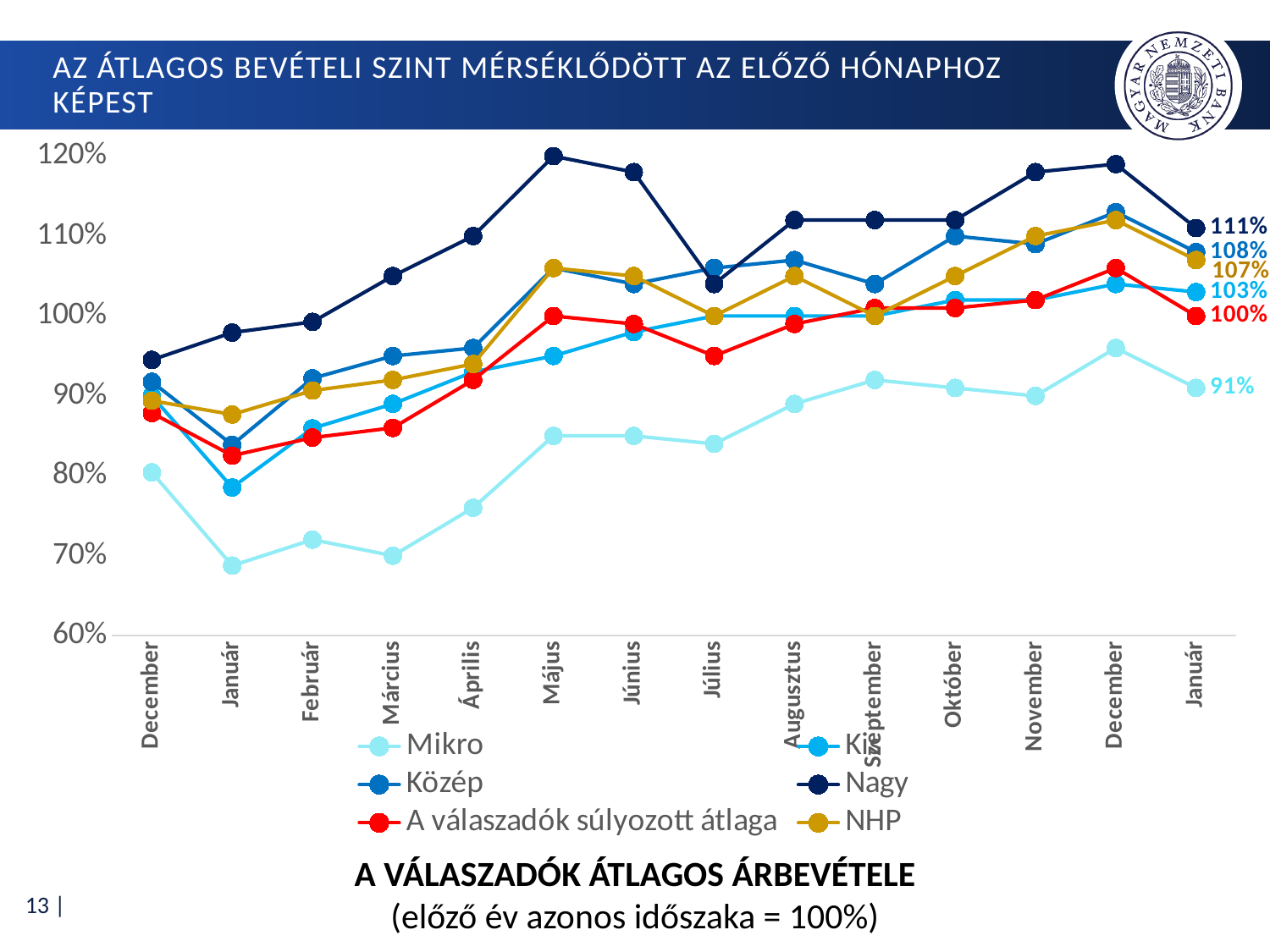
Which series has the lowest value at the final Január point? Mikro Is the value for Nagy in Május greater or less than 110%? greater What is the value for the Nagy series at the final Január point? 111% What is the difference between the Nagy and Mikro values at the final Január point? 20 percentage points What is the value for the NHP series at the final Január point? 107% What is the value for the Mikro series at the final Január point? 91% What is the value for the Közép series at the final Január point? 108% What is the title printed below the chart? A VÁLASZADÓK ÁTLAGOS ÁRBEVÉTELE What kind of chart is shown on the slide? line chart Which series has the highest value at the final Január point? Nagy How many series does the legend list? 6 At the final Január point, which is larger: Közép or Kis? Közép